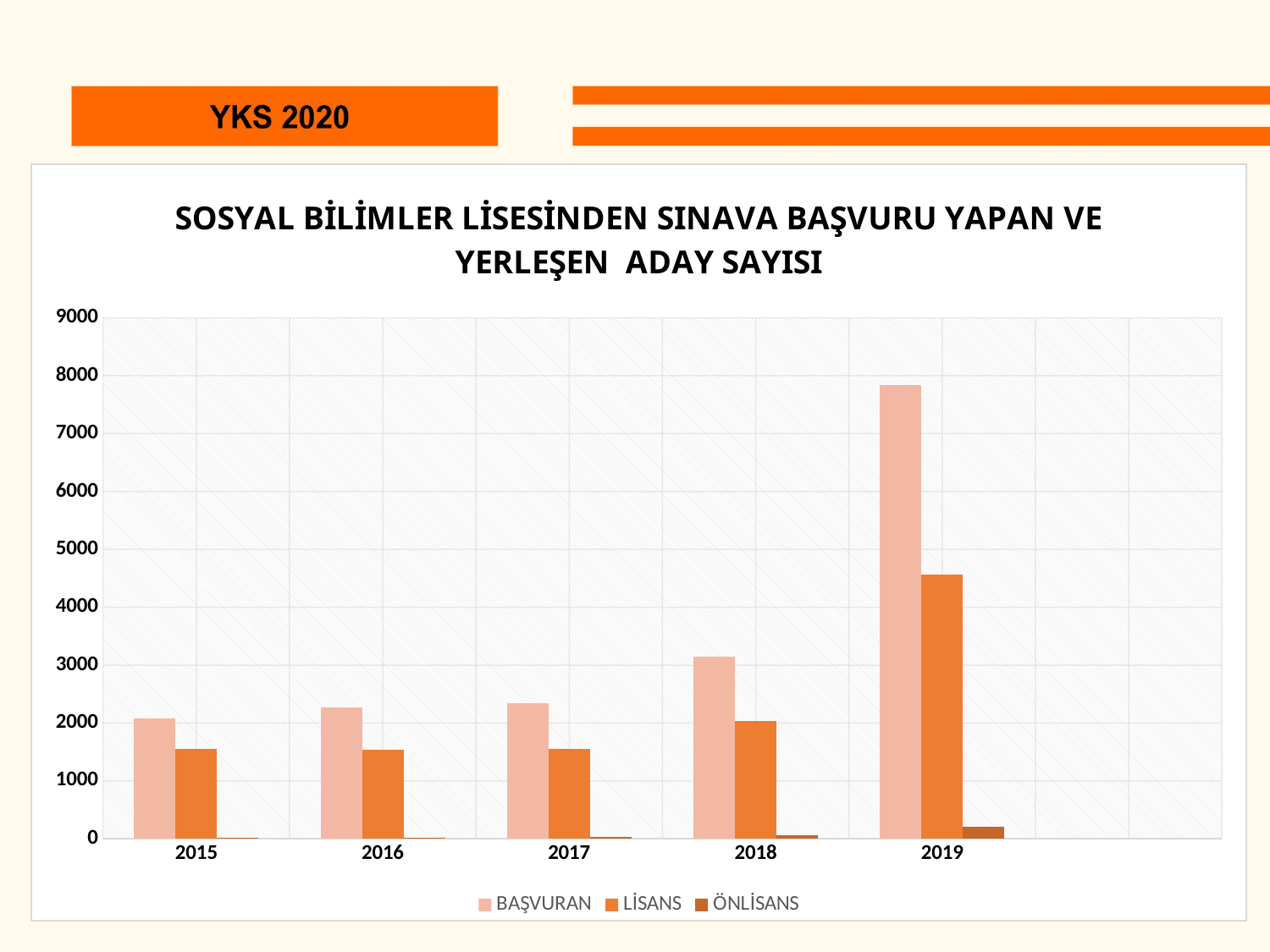
Is the LİSANS value for 2019 greater or less than 5000? less In 2019, which is larger, the BAŞVURAN value or the LİSANS value? BAŞVURAN Is the BAŞVURAN value for 2019 greater or less than 7000? greater Do the BAŞVURAN values rise or fall from 2015 to 2019? rise Which year has the highest BAŞVURAN value? 2019 How many series does the legend list? 3 What kind of chart is shown on the slide? bar chart How many years are shown on the x axis of the chart? 5 Which year has the highest LİSANS value? 2019 Is the BAŞVURAN value for 2018 greater or less than 4000? less Which year has the highest ÖNLİSANS value? 2019